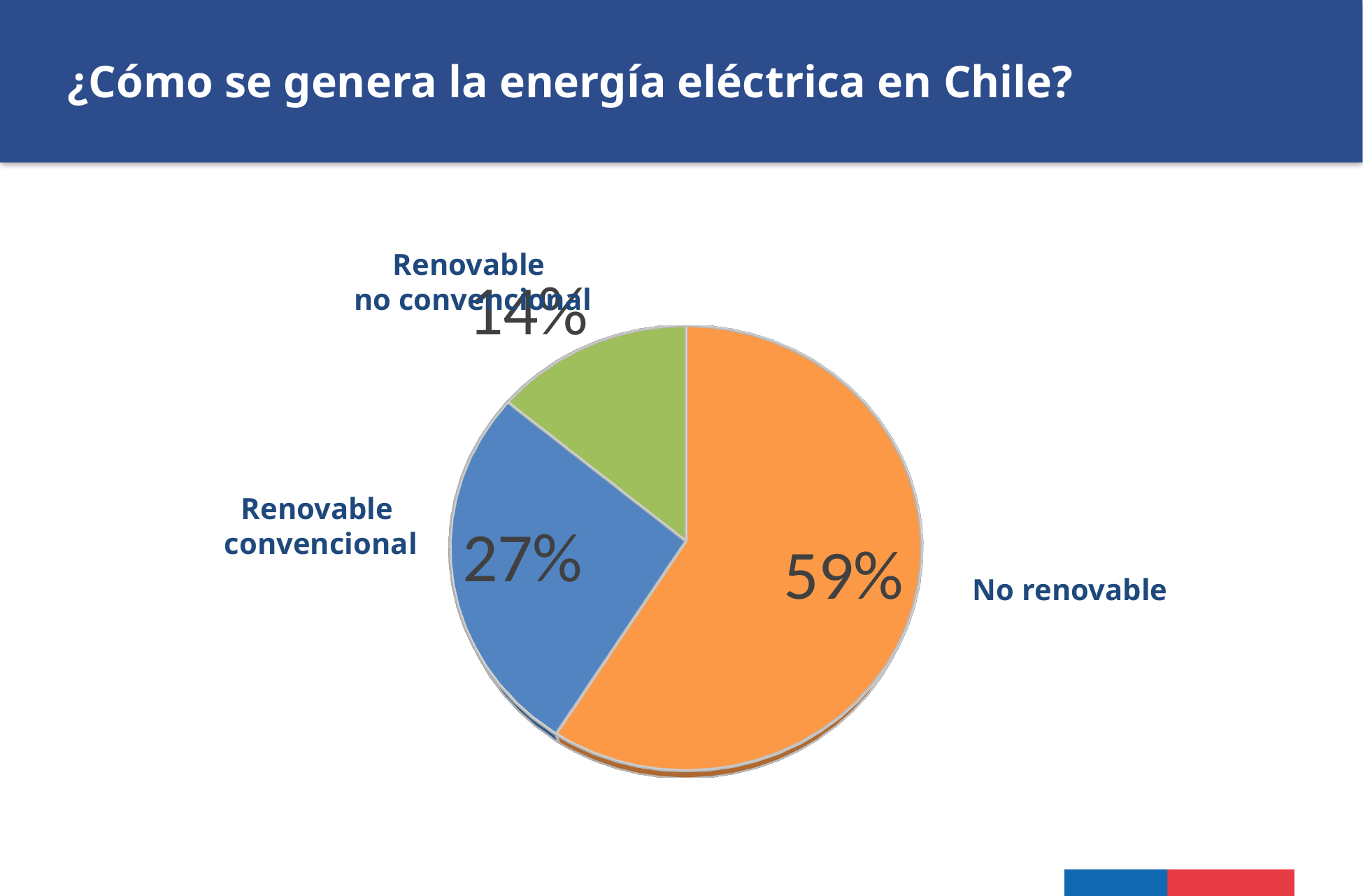
What colour is the slice for No renovable? Orange What is the value shown for Renovable no convencional? 14% What kind of chart is shown on the slide? Pie chart What is the combined share of the two renewable categories (Renovable convencional and Renovable no convencional)? 41% What is the difference in percentage points between Renovable convencional and Renovable no convencional? 13 What is the value shown for Renovable convencional? 27% What is the difference in percentage points between No renovable and Renovable convencional? 32 What share of the pie does No renovable represent? 59% How many categories are shown in the pie chart? 3 Which category has the largest slice of the pie? No renovable Which category has the smallest slice of the pie? Renovable no convencional Which is larger, Renovable convencional or Renovable no convencional? Renovable convencional